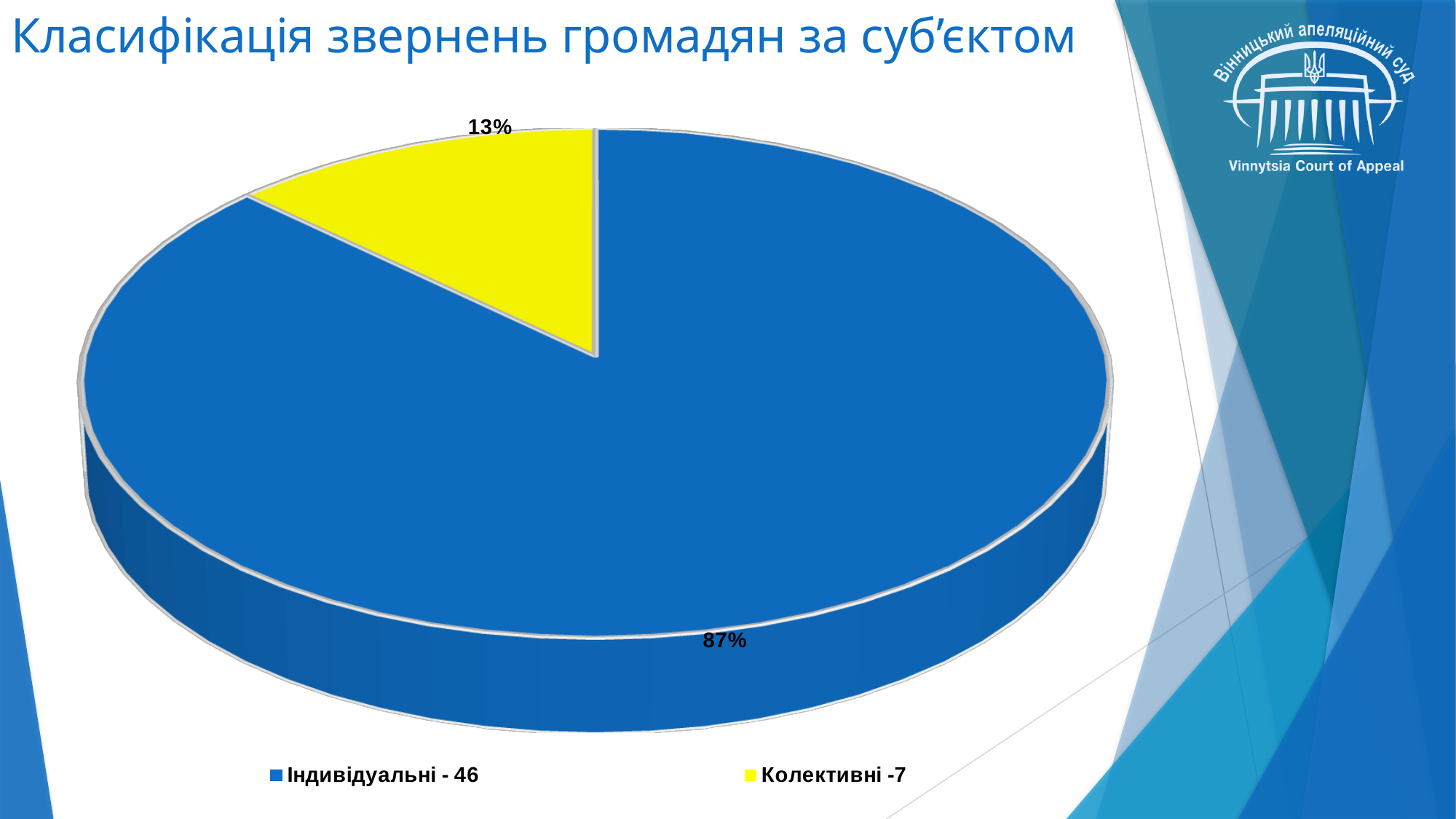
What is the difference in percentage points between the Індивідуальні and Колективні slices? 74 percentage points What type of chart is shown on the slide? Pie chart How many entries does the legend list? 2 Which category has the largest slice of the pie? Індивідуальні What number is shown next to Індивідуальні in the legend? 46 What number is shown next to Колективні in the legend? 7 What colour is the Колективні slice? Yellow Which category has the smallest slice of the pie? Колективні What share of the pie does the Колективні slice represent? 13% How many categories does the pie chart have? 2 Which slice is larger, Індивідуальні or Колективні? Індивідуальні What share of the pie does the Індивідуальні slice represent? 87%